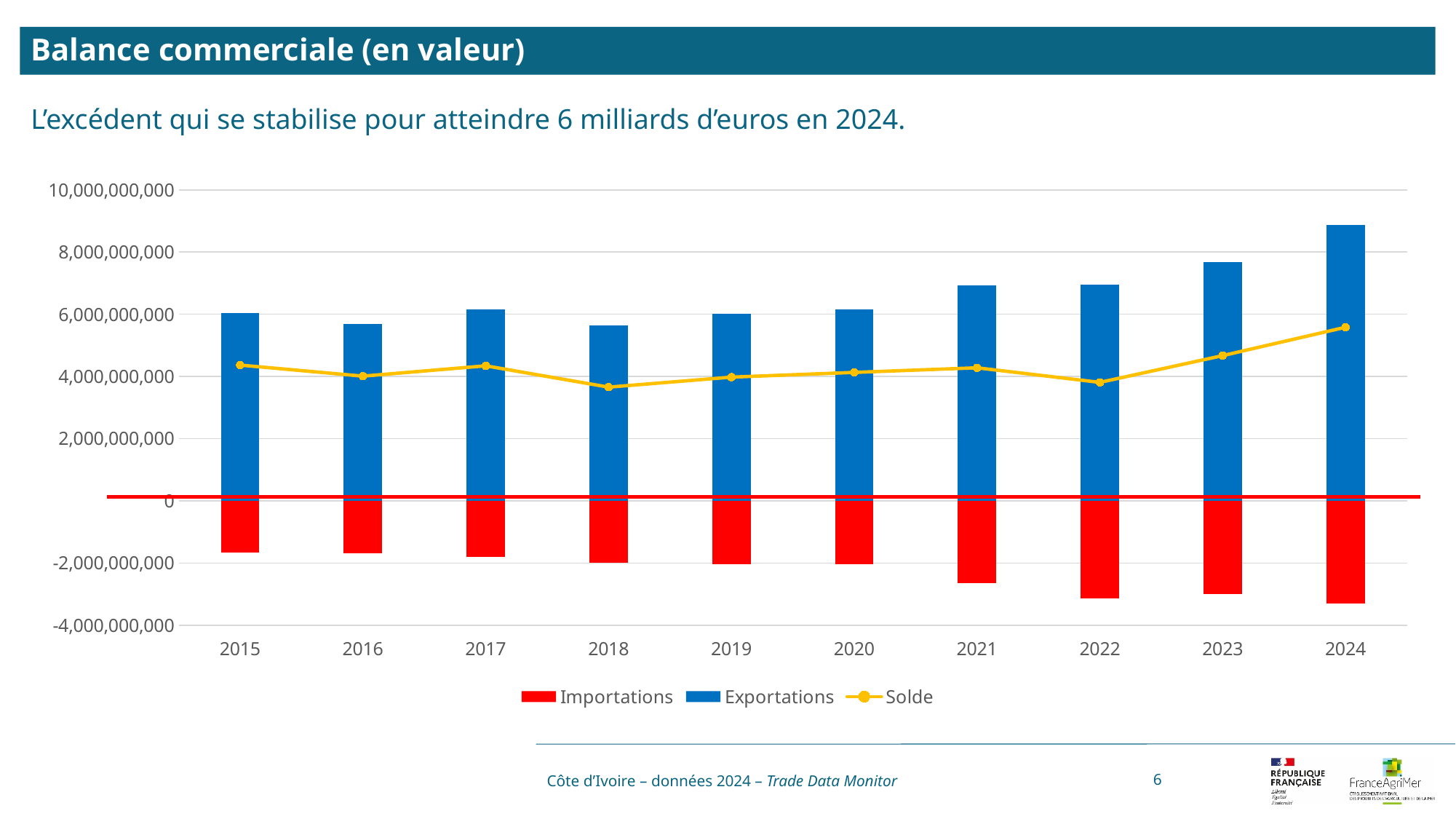
In which year is the Solde line at its highest point? 2024 What kind of chart is shown on the slide? Combined bar and line chart Is the value for Exportations in 2024 greater or less than 8,000,000,000? greater Is the value for Solde in 2018 greater or less than 4,000,000,000? less How many series does the legend list? 3 Which is larger, Exportations in 2022 or Exportations in 2023? 2023 Is the value for Importations in 2024 greater or less than -2,000,000,000? less How many years are shown on the x axis? 10 Does the Solde line rise or fall from 2022 to 2024? rise Which series is drawn as a yellow line with markers? Solde In which year are Exportations highest? 2024